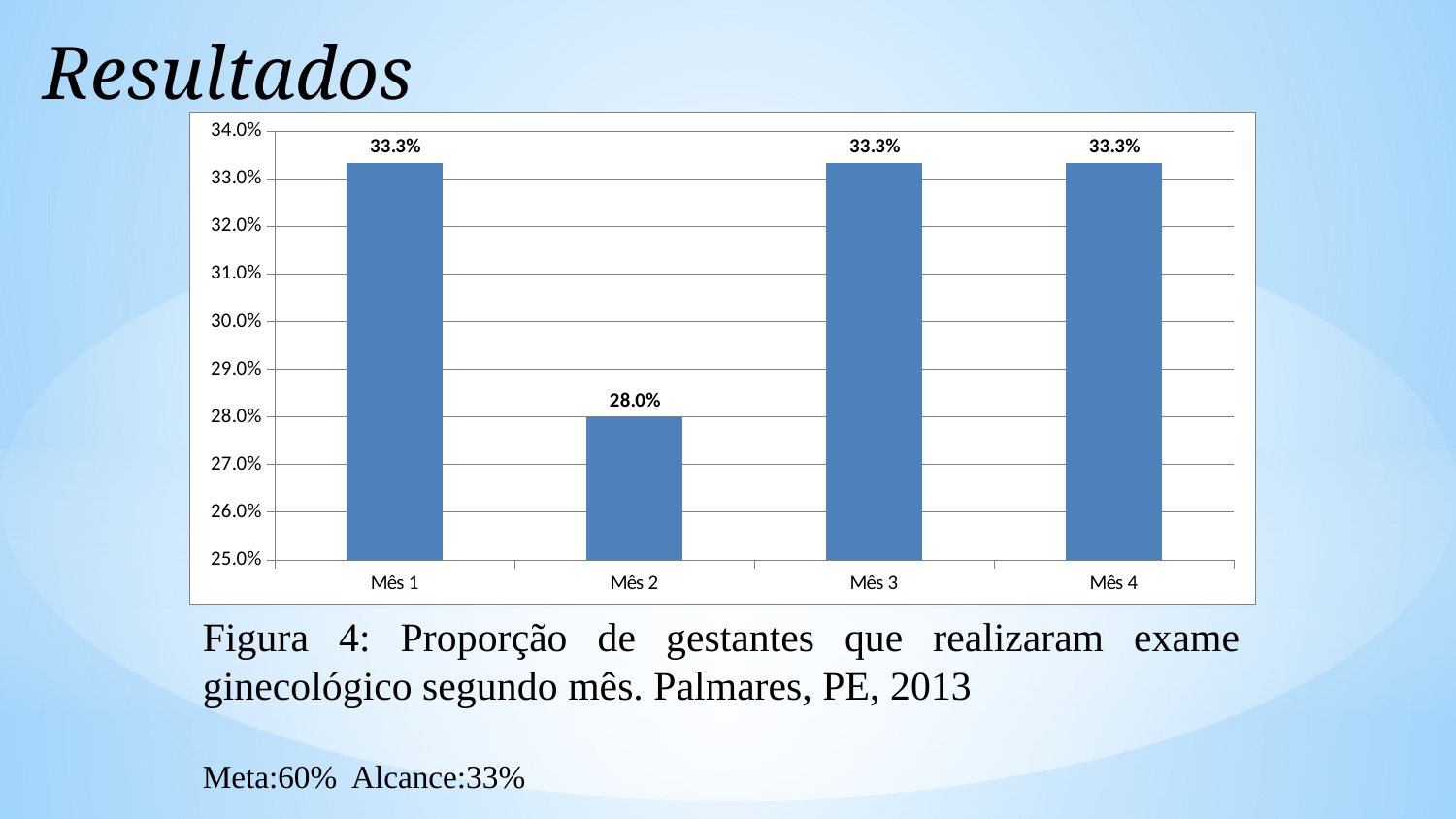
Which is larger, the value for Mês 3 or the value for Mês 2? Mês 3 What is the value for Mês 1? 33.3% Does the value rise or fall from Mês 1 to Mês 2? fall How many months are shown on the x axis? 4 Is the value for Mês 4 greater or less than 33.0%? greater What is the value for Mês 2? 28.0% What kind of chart is shown on the slide? bar chart What is the figure number given in the caption below the chart? Figura 4 What is the value for Mês 4? 33.3% Which month has the lowest value? Mês 2 What is the difference between the values for Mês 1 and Mês 2? 5.3% Is the value for Mês 2 greater or less than 30.0%? less